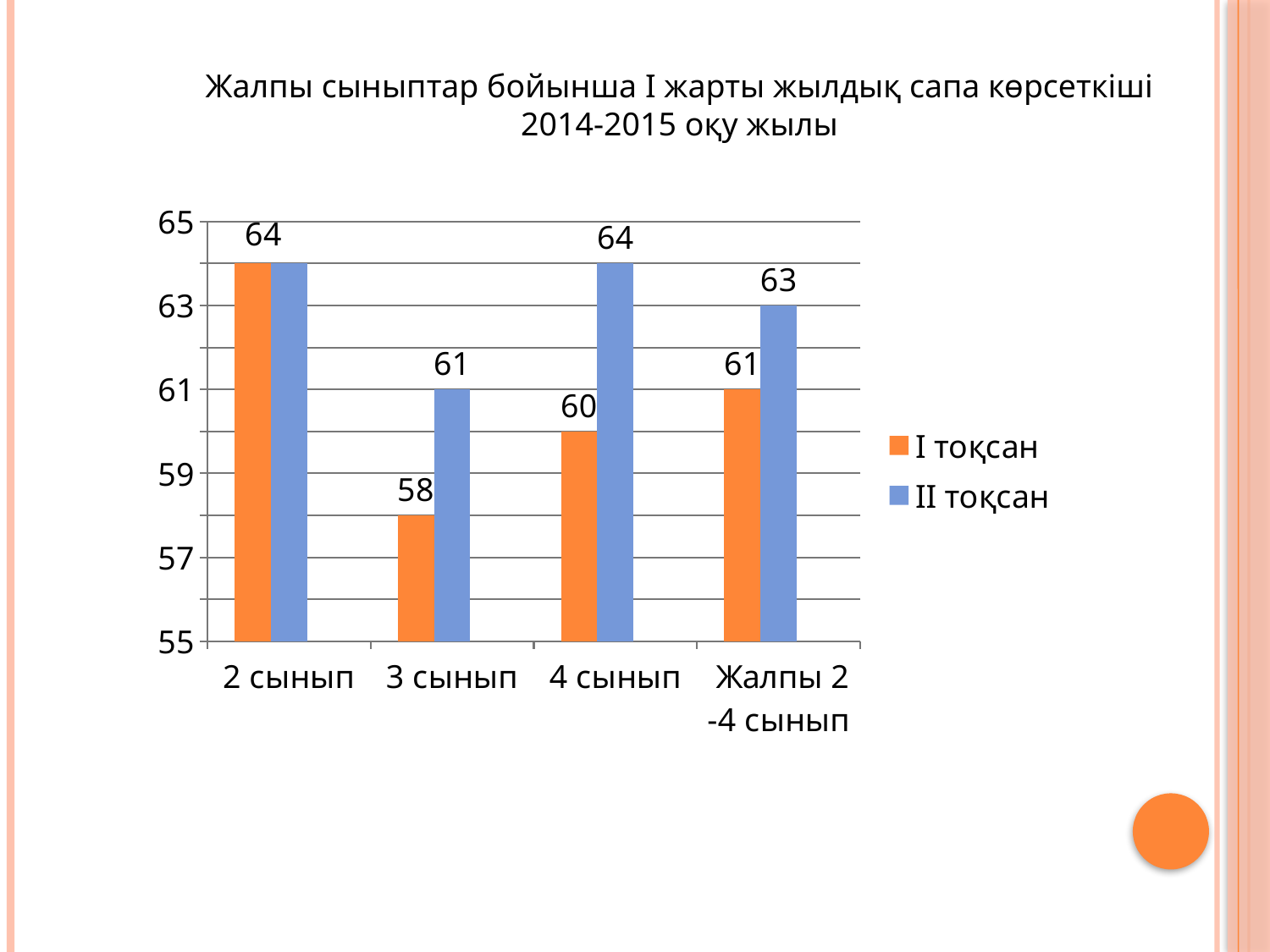
What is the value of I тоқсан for 3 сынып? 58 What is the value of I тоқсан for Жалпы 2-4 сынып? 61 Which is larger: the I тоқсан value for 4 сынып or the I тоқсан value for Жалпы 2-4 сынып? Жалпы 2-4 сынып What is the difference between the II тоқсан and I тоқсан values for 3 сынып? 3 What is the value of II тоқсан for 4 сынып? 64 Which category has the lowest II тоқсан value? 3 сынып How many categories are shown on the x axis? 4 What is the value of II тоқсан for 3 сынып? 61 How many series does the legend list? 2 What kind of chart is shown on the slide? bar chart Which category has the lowest I тоқсан value? 3 сынып What is the difference between the II тоқсан and I тоқсан values for 4 сынып? 4